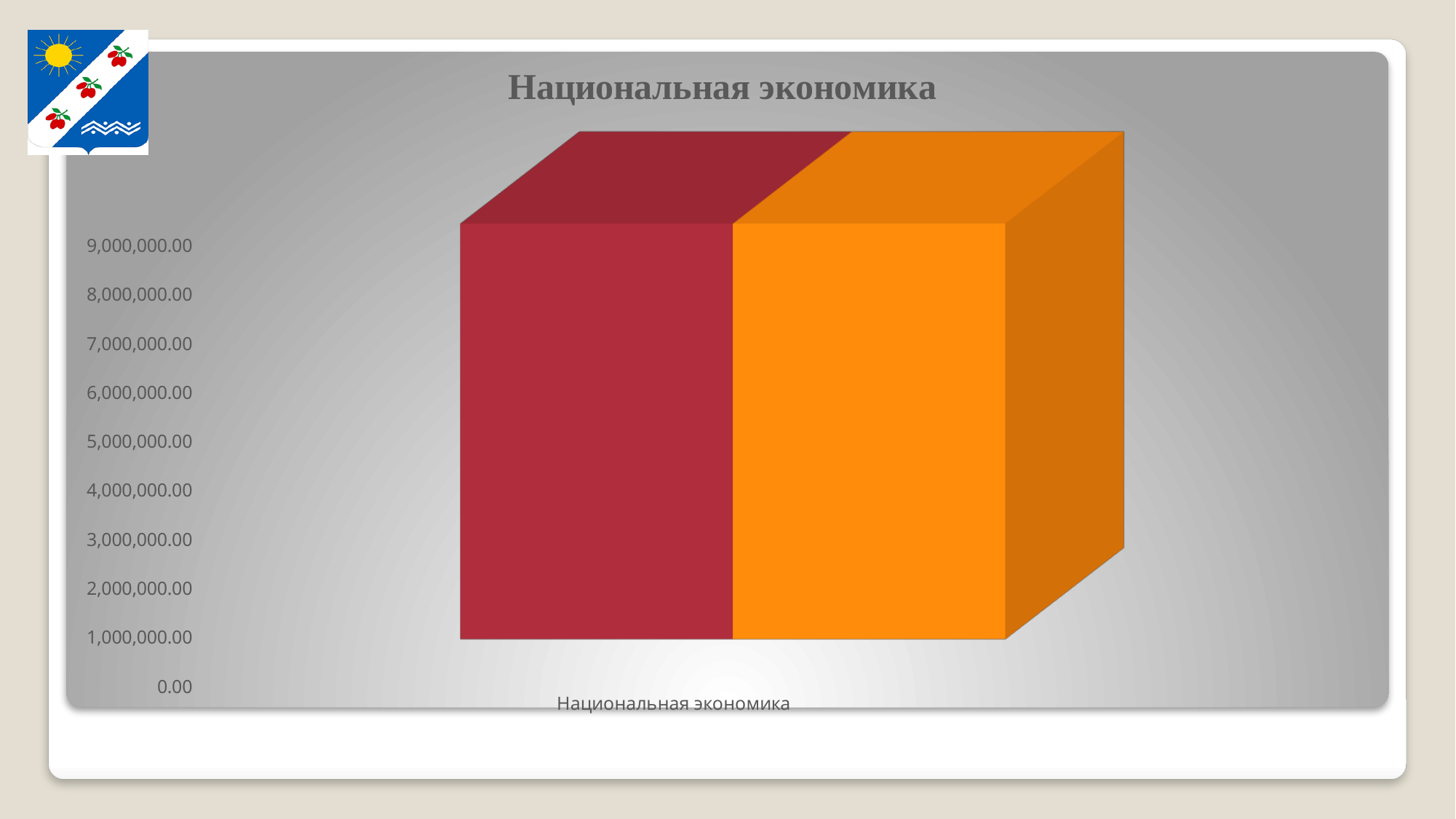
What is the highest value shown on the vertical axis of the chart? 9,000,000.00 Is the value of the red bar greater or less than 4,000,000.00? greater What is the title of the chart? Национальная экономика How many bars are plotted in the chart? 2 Is the value of the orange bar greater or less than 4,000,000.00? greater What is the category label on the x axis of the chart? Национальная экономика How many categories are shown on the x axis of the chart? 1 What kind of chart is shown on the slide? bar chart